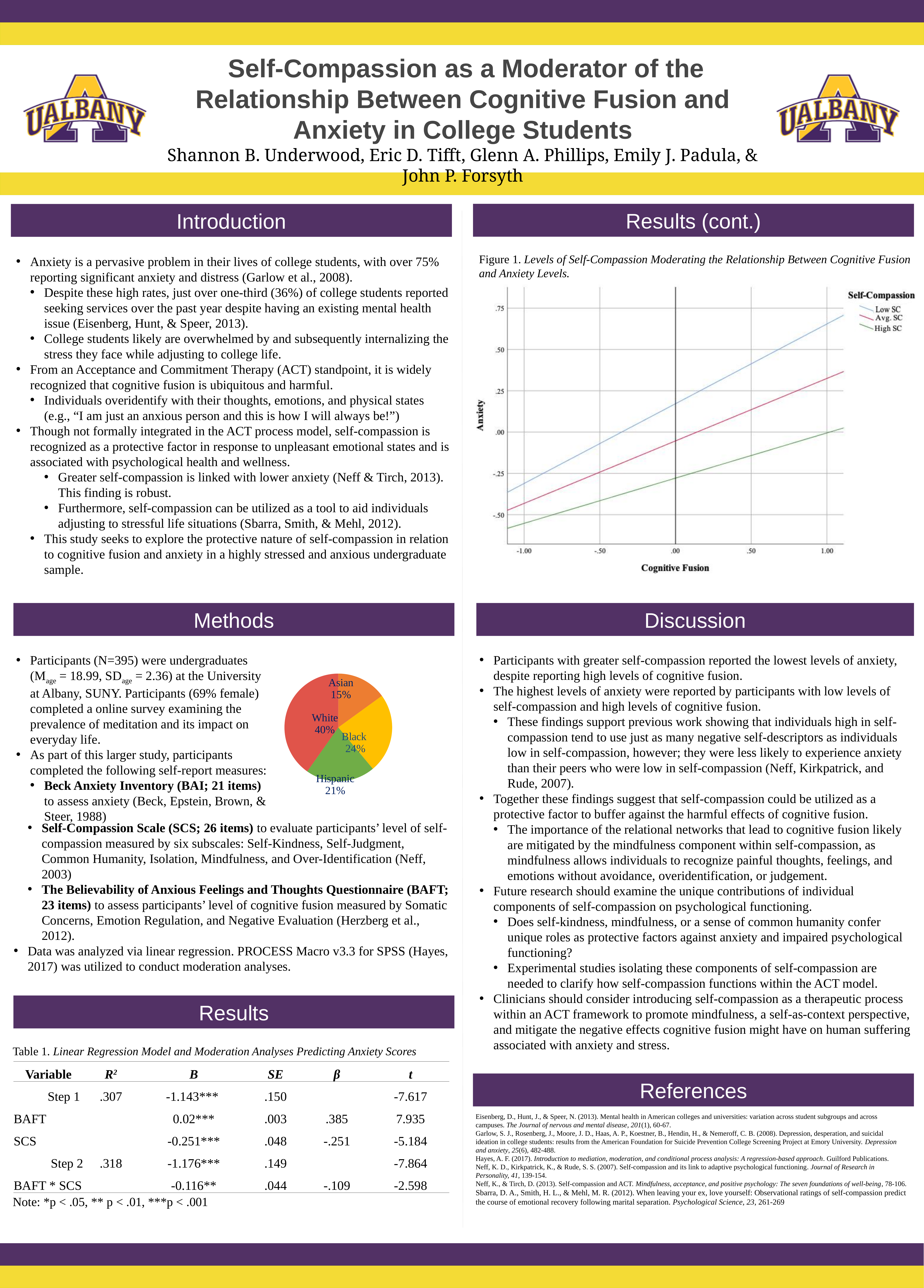
How many series does the legend of Figure 1 list? 3 On the pie chart in the Methods section, which group has the largest share? White On the pie chart in the Methods section, what percentage of participants were White? 40% What kind of chart is shown in the Methods section? Pie chart In Figure 1, does the Low SC line rise or fall as Cognitive Fusion increases? Rise On the pie chart in the Methods section, which slice is larger, Black or Hispanic? Black On the pie chart in the Methods section, what is the difference in percentage points between the Black and Asian slices? 9 In Figure 1, is the Anxiety value for the Low SC line at Cognitive Fusion 1.00 greater or less than .50? greater On the pie chart in the Methods section, what percentage of participants were Hispanic? 21% What kind of chart is Figure 1 in the Results (cont.) section? Line chart How many slices does the pie chart in the Methods section have? 4 On the pie chart in the Methods section, which group has the smallest share? Asian